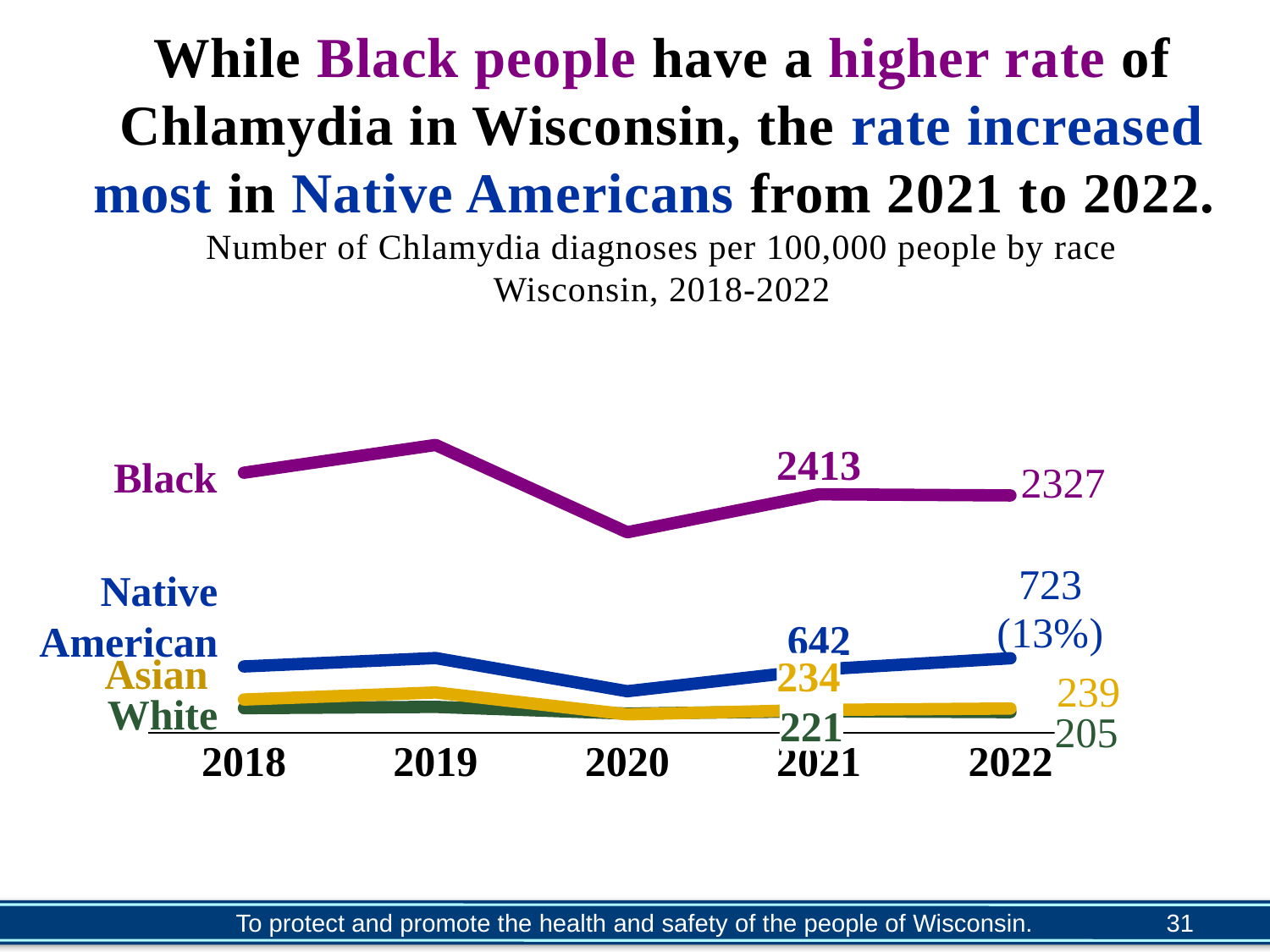
What was the Chlamydia rate per 100,000 for Black people in Wisconsin in 2021? 2413 What was the Chlamydia rate per 100,000 for White people in 2022? 205 Which was larger in 2021, the Chlamydia rate for Asian people or for White people? Asian What was the Chlamydia rate per 100,000 for Native Americans in Wisconsin in 2022? 723 What is the difference between the Black and Native American Chlamydia rates in 2022? 1604 How many years are shown on the x axis of the chart? 5 Which race had the highest Chlamydia rate in 2022? Black How many race groups are plotted as lines on the chart? 4 By how much did the Chlamydia rate for Native Americans change from 2021 to 2022? 81 What type of chart is shown on the slide? Line chart Which race had the lowest Chlamydia rate in 2022? White What was the Chlamydia rate per 100,000 for Asian people in 2021? 234